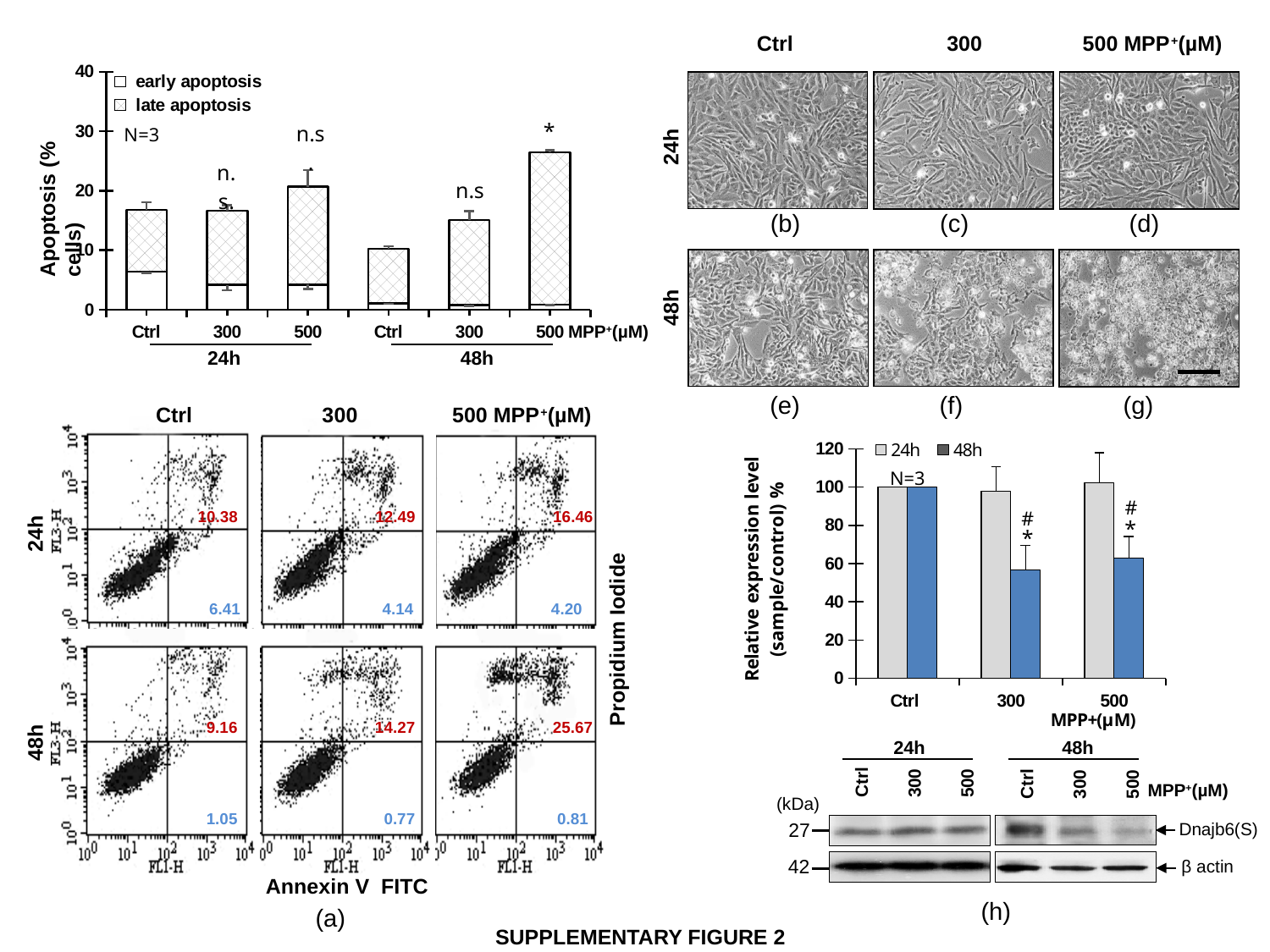
In the relative expression level chart at the bottom right, what is the relative expression level for Ctrl at 24h? 100 In the apoptosis bar chart at the top left, is the total apoptosis for Ctrl at 24h greater or less than 20? less In the relative expression level chart at the bottom right, at 300 MPP+, which is larger, the 24h value or the 48h value? 24h In the apoptosis bar chart at the top left, what are the two legend entries? early apoptosis, late apoptosis In the relative expression level chart at the bottom right, is the 48h value for 300 MPP+ greater or less than 80? less In the flow cytometry plots at the bottom left, what is the upper-right quadrant value for 500 MPP+ at 48h? 25.67 In the apoptosis bar chart at the top left, which bar is the highest? 500 MPP+ at 48h In the apoptosis bar chart at the top left, how many series does the legend list? 2 In the apoptosis bar chart at the top left, is the total apoptosis for 500 MPP+ at 48h greater or less than 20? greater In the relative expression level chart at the bottom right, how many series does the legend list? 2 In the apoptosis bar chart at the top left, how many bars are plotted? 6 In the relative expression level chart at the bottom right, what kind of chart is it? bar chart